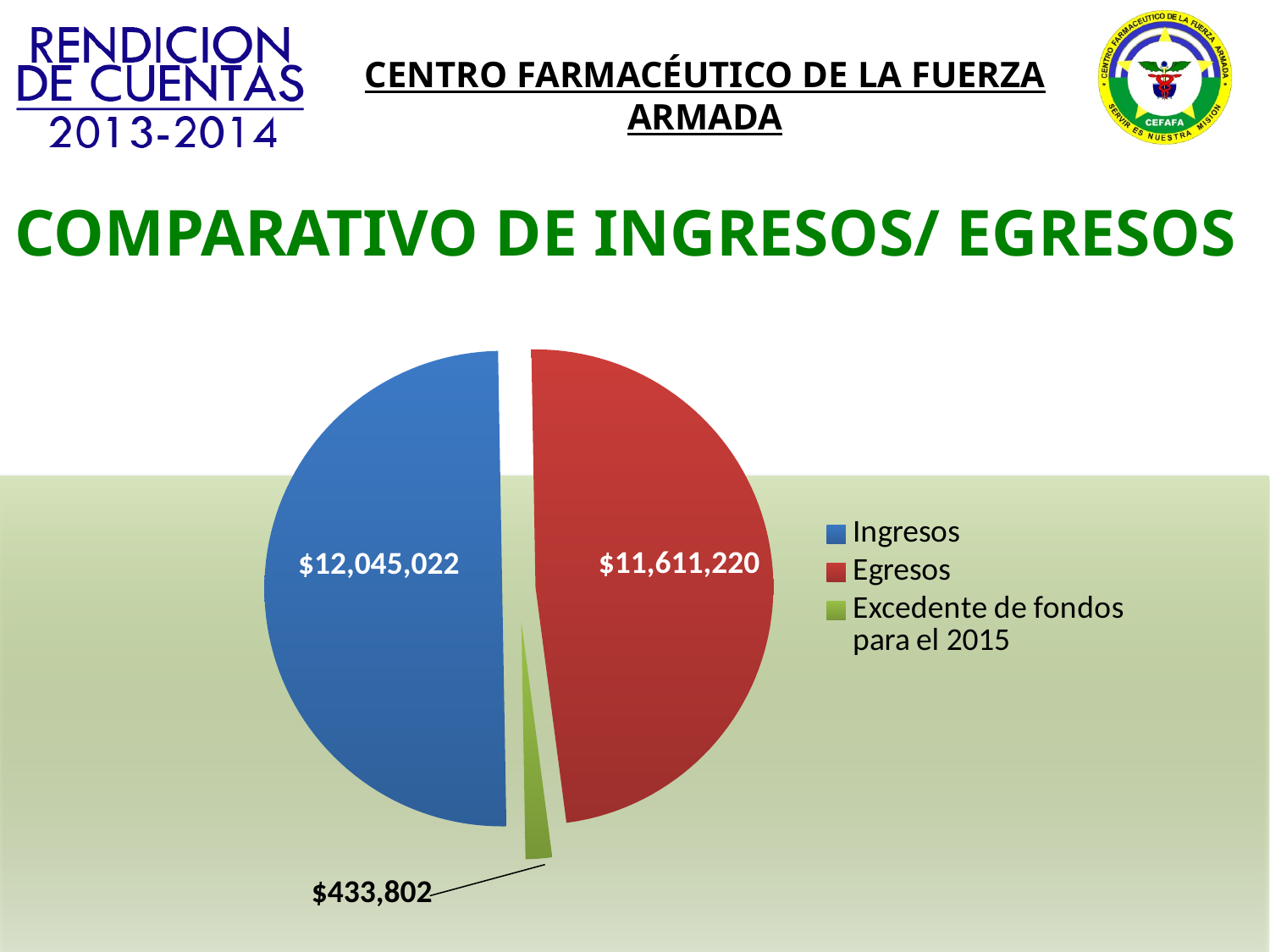
Which is larger, Ingresos or Egresos? Ingresos Which category has the smallest slice of the pie? Excedente de fondos para el 2015 Which category has the largest slice of the pie? Ingresos What type of chart is shown on the slide? pie chart What is the value shown for Excedente de fondos para el 2015? $433,802 What is the difference between the Ingresos value and the Egresos value? $433,802 What is the value shown for Egresos? $11,611,220 How many slices does the pie chart have? 3 What is the value shown for Ingresos? $12,045,022 What colour is the Egresos slice? red How many entries does the legend list? 3 What share of the pie does the Ingresos slice represent? 50%